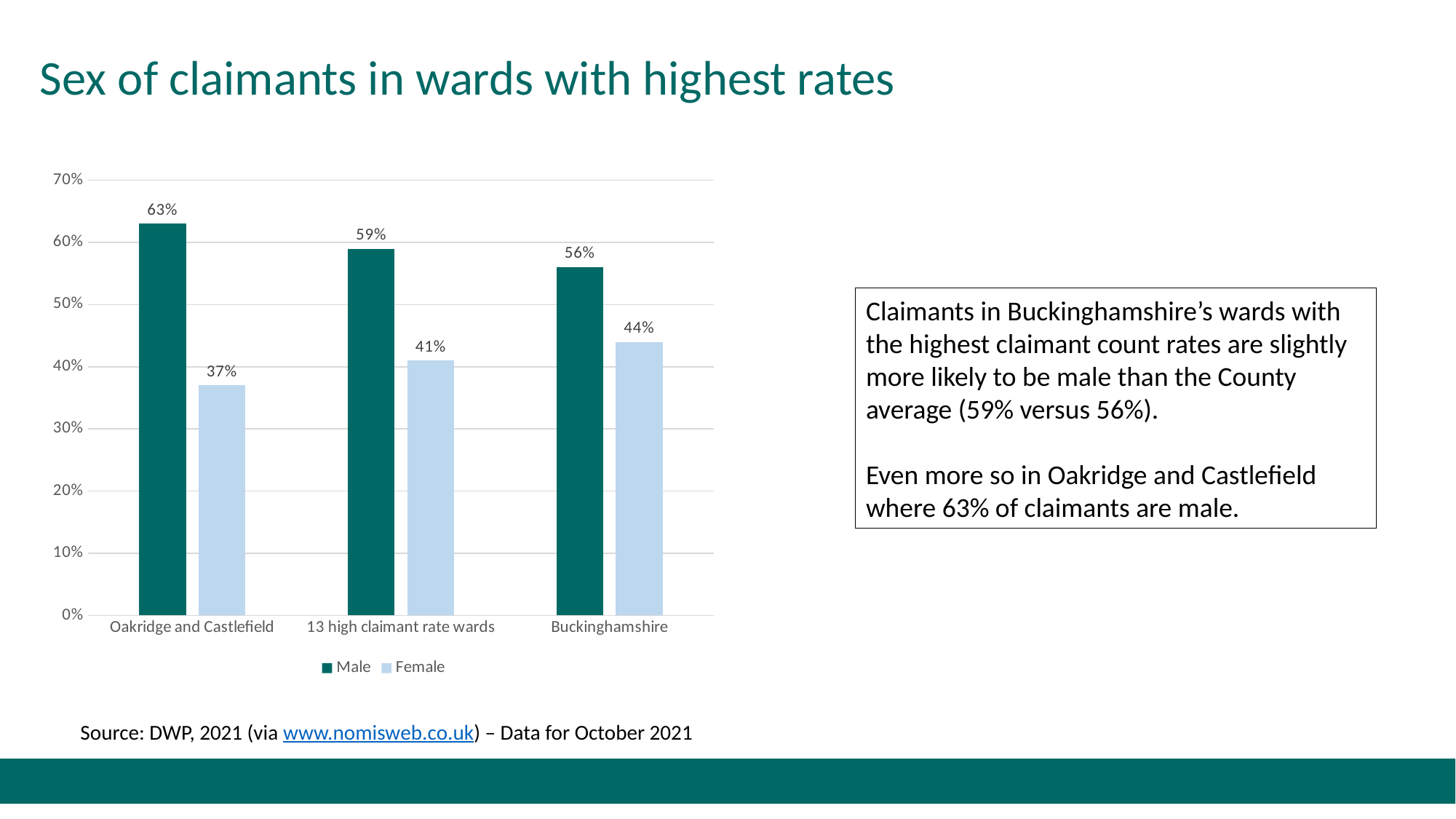
What is the Female value for Buckinghamshire? 44% Which category has the highest Male value? Oakridge and Castlefield What kind of chart is shown on the slide? Bar chart What is the Male value for Oakridge and Castlefield? 63% Do the Male values rise or fall from left to right across the categories? Fall Which is larger, the Female value for Buckinghamshire or the Female value for Oakridge and Castlefield? Buckinghamshire What is the Female value for 13 high claimant rate wards? 41% How many categories are shown on the x axis? 3 How many series does the legend list? 2 What is the difference between the Male and Female values for Oakridge and Castlefield? 26% What is the difference between the Male values for 13 high claimant rate wards and Buckinghamshire? 3% Which category has the lowest Female value? Oakridge and Castlefield